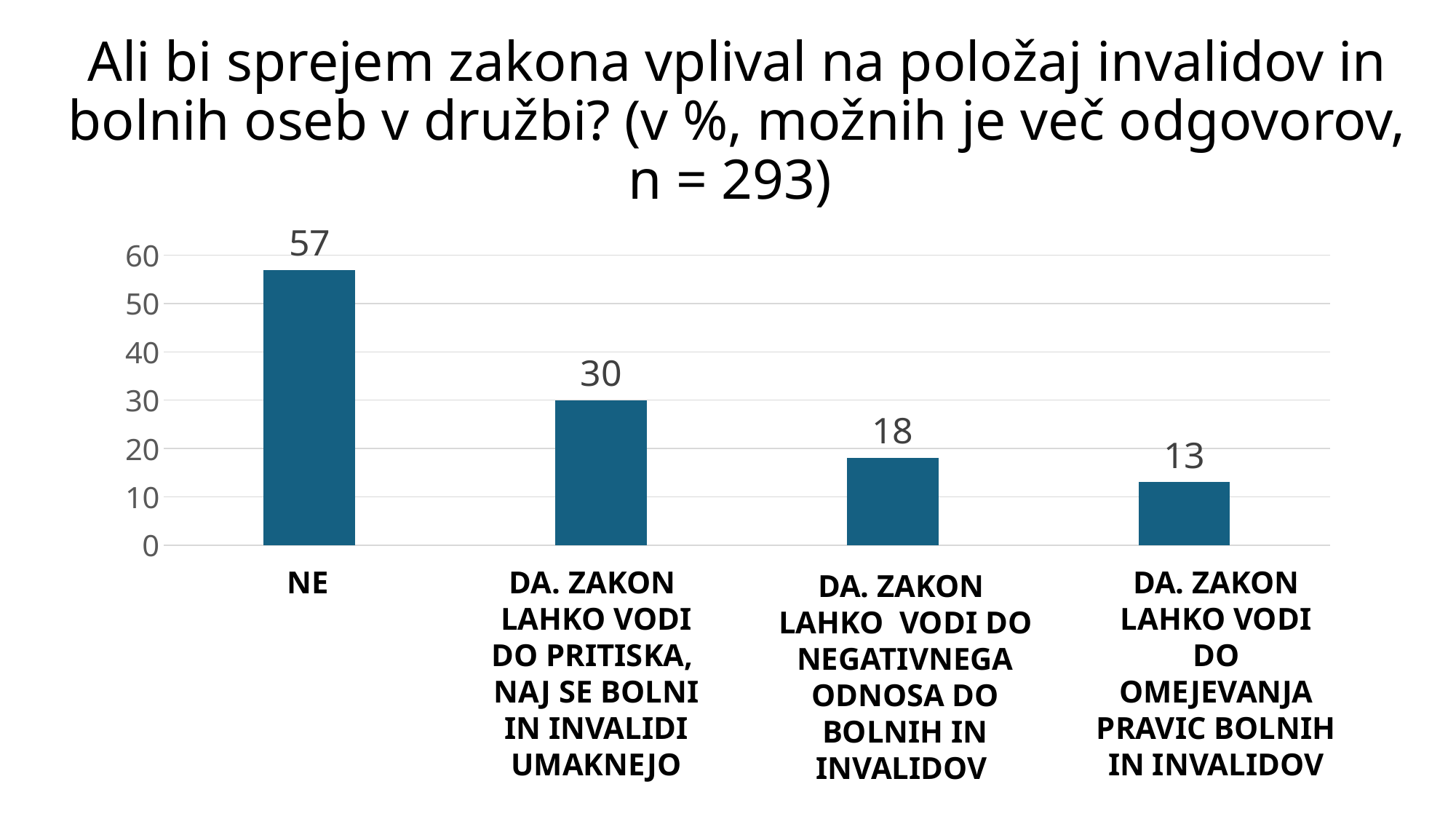
Which category has the highest value? NE Which category has the lowest value? DA. ZAKON LAHKO VODI DO OMEJEVANJA PRAVIC BOLNIH IN INVALIDOV How many categories are shown in the chart? 4 Do the values rise or fall from left to right across the categories? fall What is the value for "DA. ZAKON LAHKO VODI DO PRITISKA, NAJ SE BOLNI IN INVALIDI UMAKNEJO"? 30 What is the value for "DA. ZAKON LAHKO VODI DO NEGATIVNEGA ODNOSA DO BOLNIH IN INVALIDOV"? 18 Is the value for "NE" greater or less than 50? greater What kind of chart is shown on the slide? bar chart Which is larger: the value for "DA. ZAKON LAHKO VODI DO NEGATIVNEGA ODNOSA DO BOLNIH IN INVALIDOV" or the value for "DA. ZAKON LAHKO VODI DO OMEJEVANJA PRAVIC BOLNIH IN INVALIDOV"? DA. ZAKON LAHKO VODI DO NEGATIVNEGA ODNOSA DO BOLNIH IN INVALIDOV What is the value for "DA. ZAKON LAHKO VODI DO OMEJEVANJA PRAVIC BOLNIH IN INVALIDOV"? 13 What is the difference between the value for "NE" and the value for "DA. ZAKON LAHKO VODI DO PRITISKA, NAJ SE BOLNI IN INVALIDI UMAKNEJO"? 27 What is the value for the category "NE"? 57